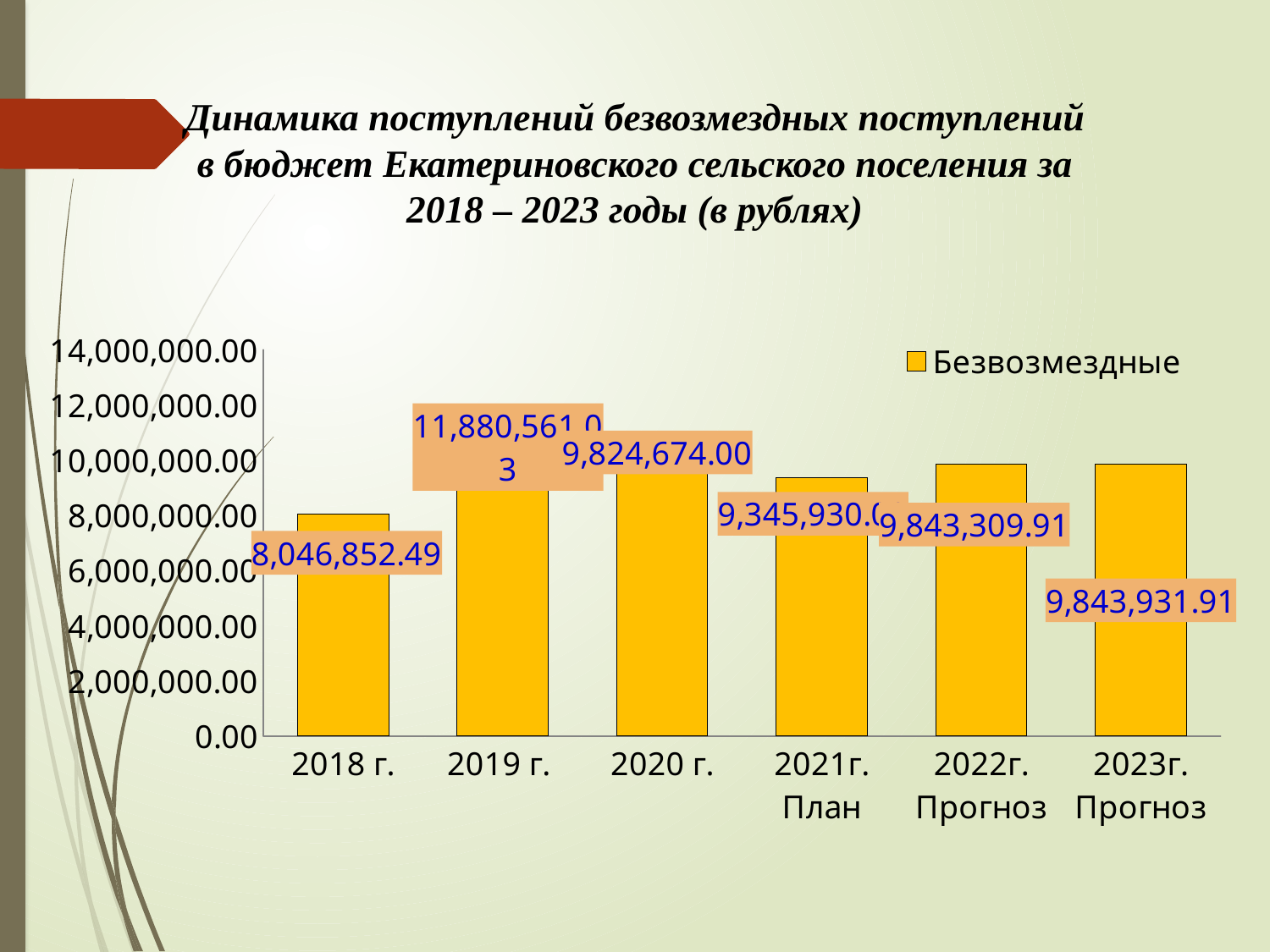
How many series does the chart legend list? 1 Is the value for 2019 г. greater or less than 10,000,000.00? greater What is the value for 2022г. Прогноз? 9,843,309.91 Which year has the lowest value in the chart? 2018 г. What is the difference between the values for 2020 г. and 2018 г.? 1,777,821.51 Which year has the highest value in the chart? 2019 г. What is the value for 2023г. Прогноз? 9,843,931.91 What is the value for 2020 г.? 9,824,674.00 What type of chart is shown on the slide? Bar chart How many categories (years) are shown on the x axis of the chart? 6 What is the name of the series shown in the legend? Безвозмездные What is the value for 2018 г.? 8,046,852.49